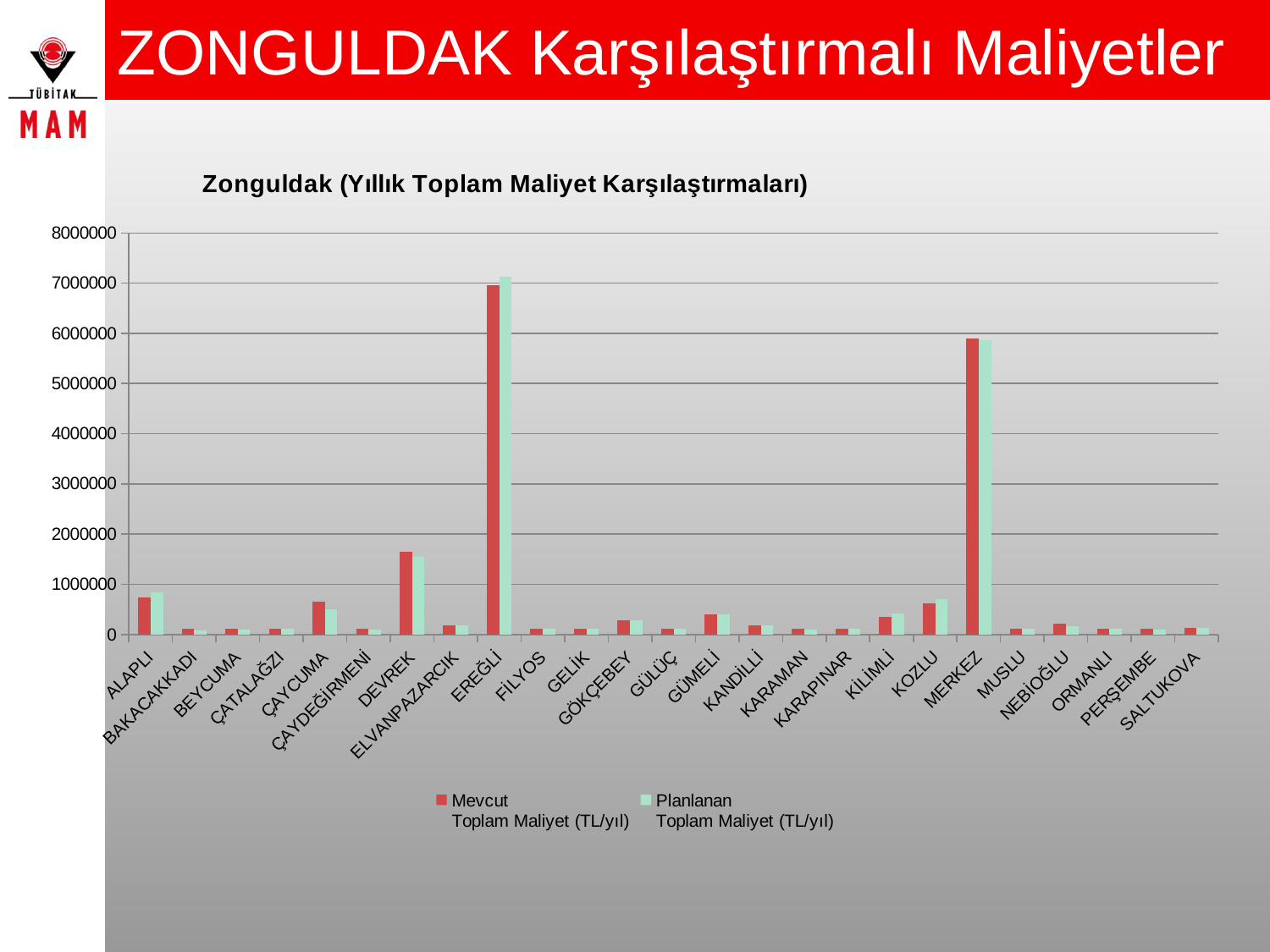
What type of chart is shown on the slide? Bar chart How many categories are shown on the x axis? 25 Which category has the highest Mevcut Toplam Maliyet (TL/yıl)? EREĞLİ Which has the larger Mevcut Toplam Maliyet (TL/yıl), EREĞLİ or MERKEZ? EREĞLİ Is the Mevcut Toplam Maliyet (TL/yıl) for MERKEZ greater or less than 5000000? greater Which category has the highest Planlanan Toplam Maliyet (TL/yıl)? EREĞLİ Is the Mevcut Toplam Maliyet (TL/yıl) for DEVREK greater or less than 1000000? greater Which has the larger Mevcut Toplam Maliyet (TL/yıl), DEVREK or ÇAYCUMA? DEVREK Is the Mevcut Toplam Maliyet (TL/yıl) for ALAPLI greater or less than 1000000? less What is the title of the chart? Zonguldak (Yıllık Toplam Maliyet Karşılaştırmaları) How many series does the legend list? 2